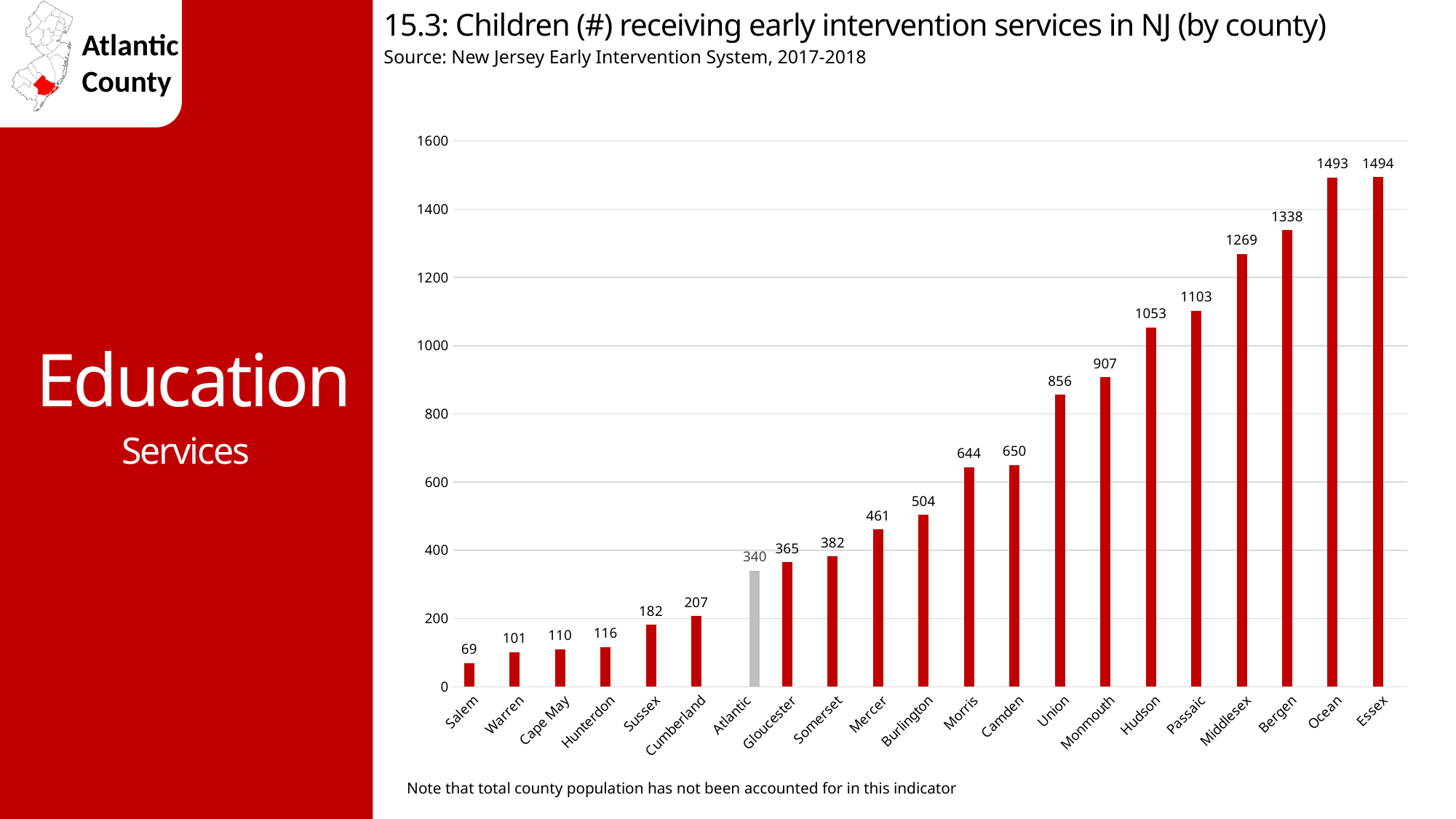
Which county has the lowest number of children receiving early intervention services? Salem Which has a larger value, Camden or Union? Union How many children received early intervention services in Atlantic County? 340 Which county's bar is shown in grey rather than red? Atlantic What is the difference between the values for Atlantic and Gloucester? 25 Is the value for Passaic greater or less than 1000? greater Which county has the highest number of children receiving early intervention services? Essex What kind of chart is shown on the slide? Bar chart What is the value shown for Hudson County? 1053 How many counties are shown on the chart? 21 What is the value shown for Cumberland County? 207 What is the difference between the values for Bergen and Middlesex? 69